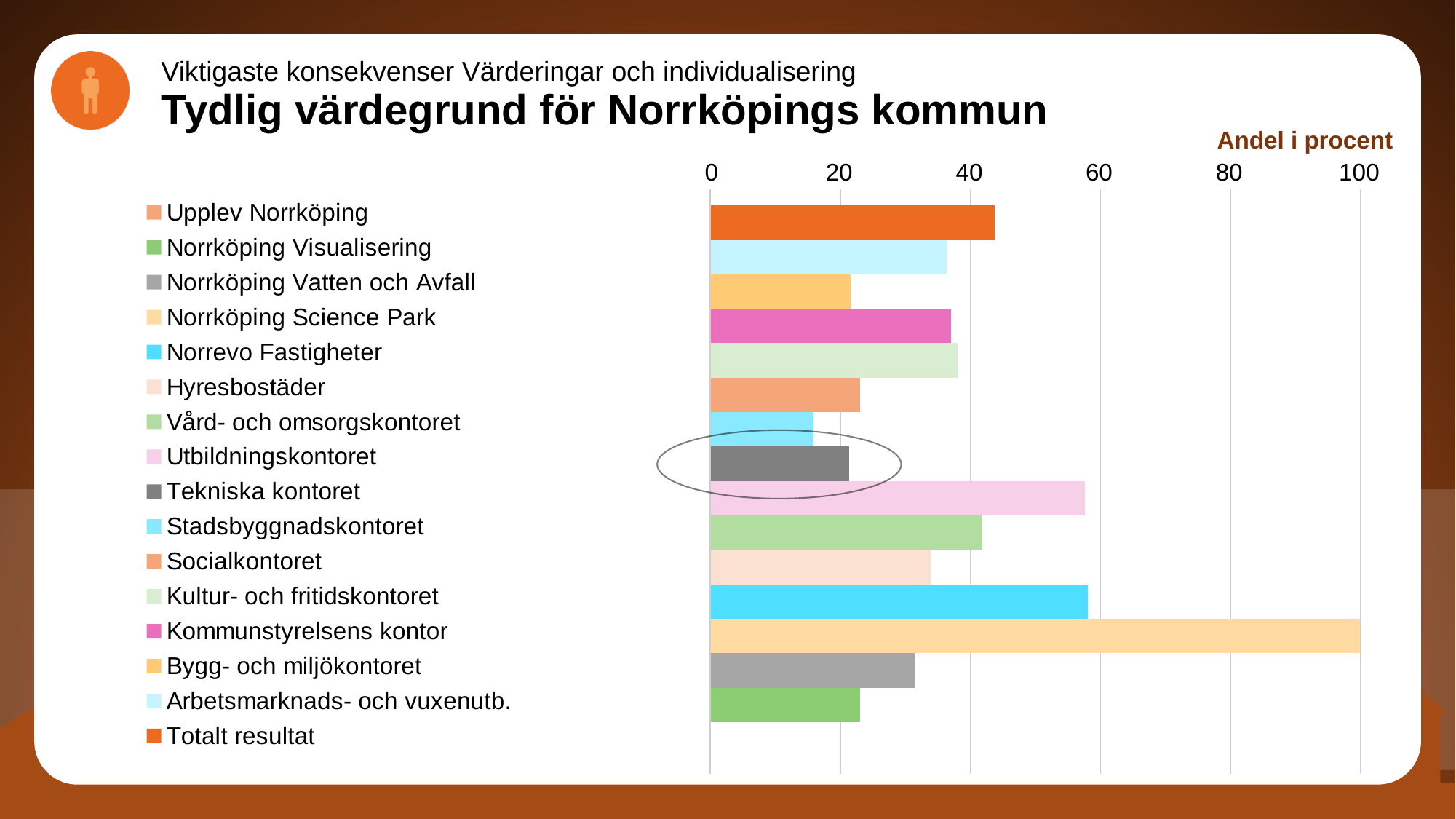
Is the value for Hyresbostäder greater or less than 40? less What kind of chart is shown on the slide? bar chart Which category has the highest value? Norrköping Science Park Which category has the lowest value among the plotted bars? Stadsbyggnadskontoret Which is larger, the value for Vård- och omsorgskontoret or the value for Hyresbostäder? Vård- och omsorgskontoret Is the value for Utbildningskontoret greater or less than 40? greater Which is larger, the value for Totalt resultat or the value for Socialkontoret? Totalt resultat What is the value for Norrköping Science Park? 100 How many entries does the legend list? 16 Is the value for Stadsbyggnadskontoret greater or less than 20? less What label is shown above the horizontal axis of the chart? Andel i procent